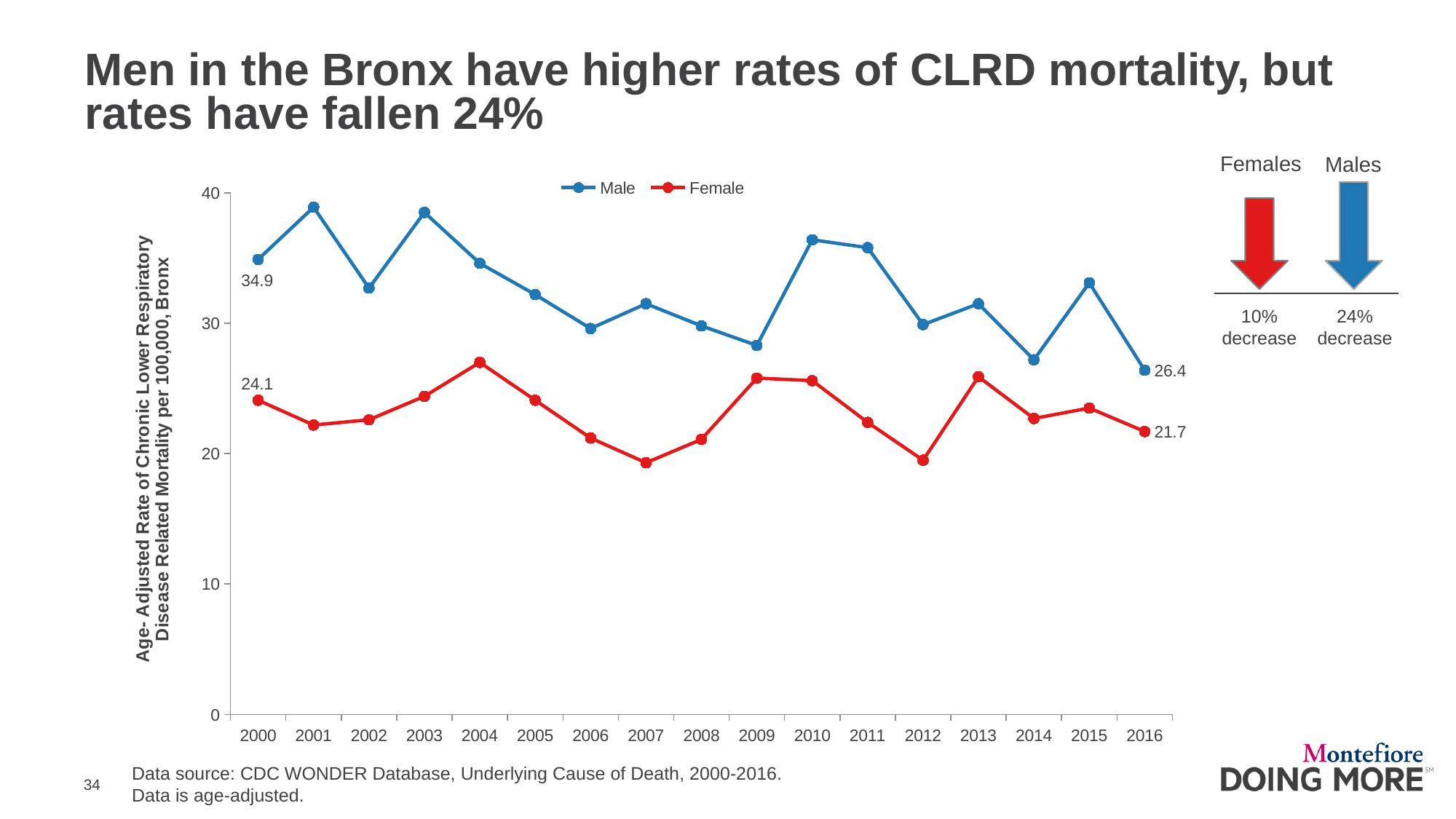
By how much did the male rate fall between 2000 and 2016? 8.5 How many years are shown on the x axis? 17 What is the male CLRD mortality rate in 2000? 34.9 What is the difference between the male and female rates in 2016? 4.7 Is the male rate in 2010 greater or less than 30? greater What is the male CLRD mortality rate in 2016? 26.4 What is the female CLRD mortality rate in 2016? 21.7 In 2016, which series has the higher rate, Male or Female? Male What kind of chart is shown on the slide? Line chart Is the female rate in 2007 greater or less than 20? less What is the female CLRD mortality rate in 2000? 24.1 In which year is the female rate highest? 2004